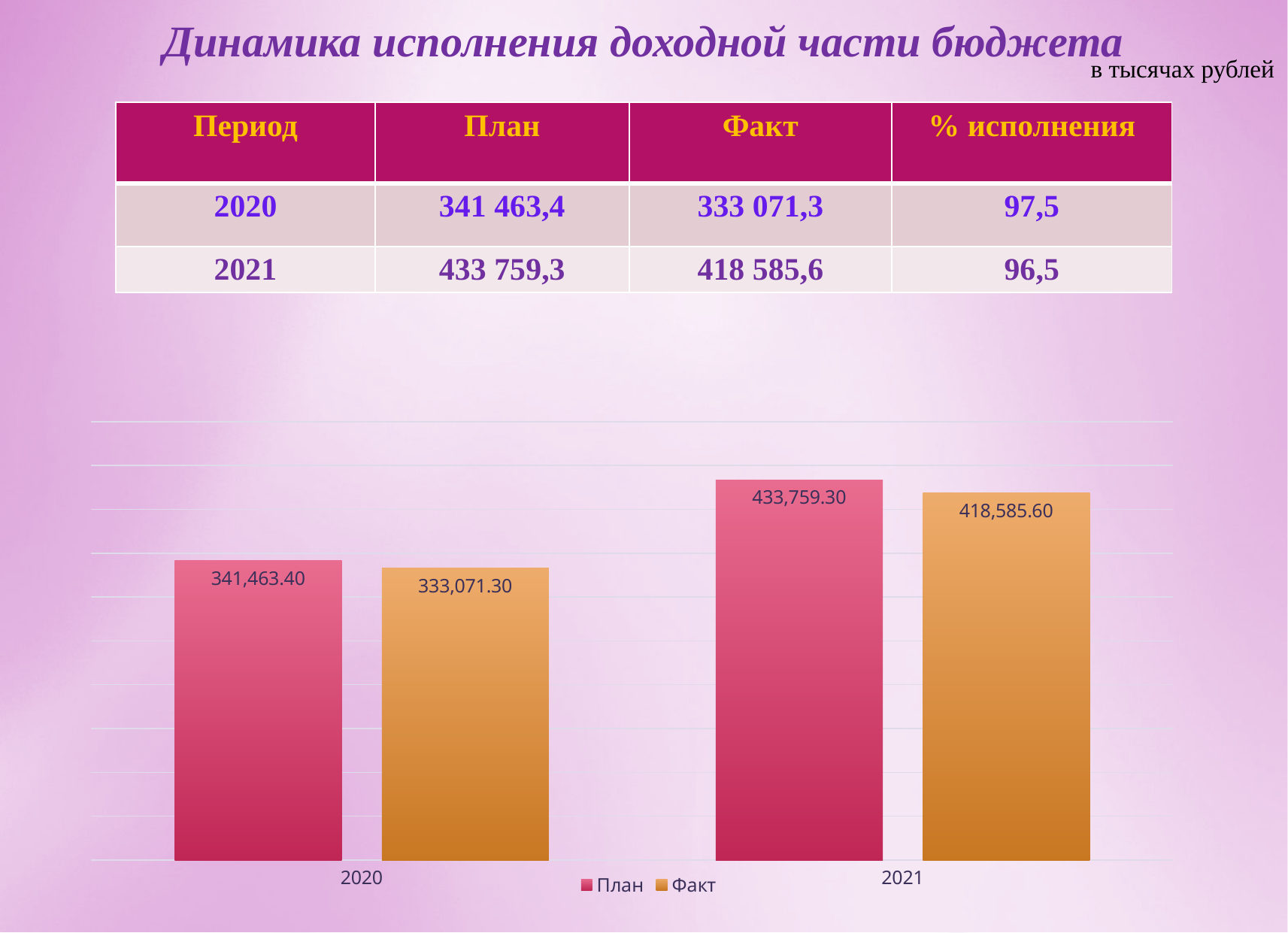
What kind of chart is shown on the slide? Bar chart Do the Факт values rise or fall from 2020 to 2021 in the chart? Rise What is the value of the План bar for 2020 in the chart? 341,463.40 What is the difference between the План and Факт values for 2020 in the chart? 8,392.10 How many series does the chart legend list? 2 Which bar in the chart has the highest value? План 2021 What is the difference between the План and Факт values for 2021 in the chart? 15,173.70 What is the value of the Факт bar for 2020 in the chart? 333,071.30 Which bar in the chart has the lowest value? Факт 2020 In the chart, which is larger for 2020: План or Факт? План How many categories (years) are shown on the x axis of the chart? 2 What is the value of the Факт bar for 2021 in the chart? 418,585.60